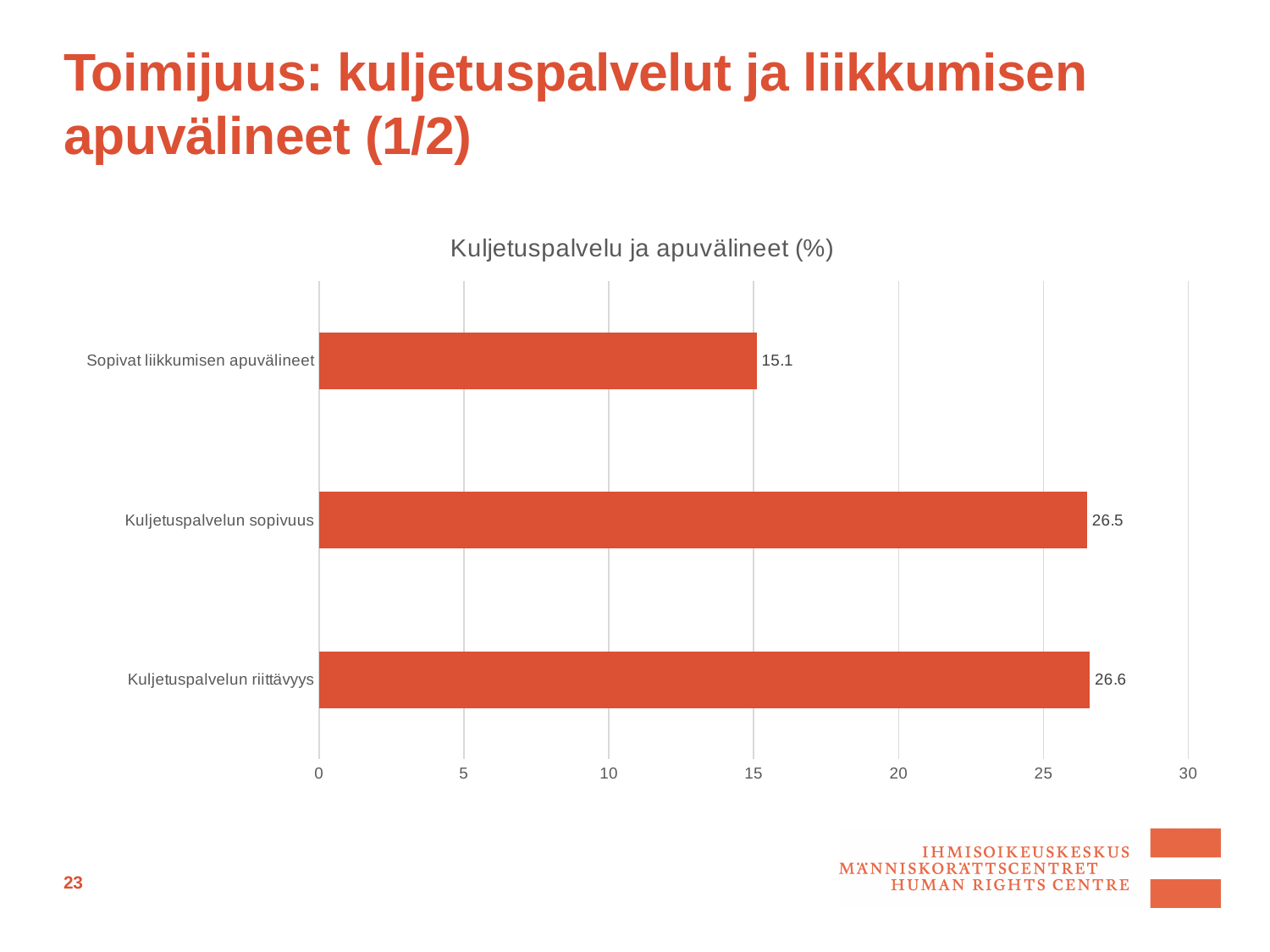
Which category has the lowest value? Sopivat liikkumisen apuvälineet Is the value for Kuljetuspalvelun riittävyys greater or less than 25? greater Is the value for Sopivat liikkumisen apuvälineet greater or less than 20? less What is the value for Sopivat liikkumisen apuvälineet? 15.1 What is the difference between the values for Kuljetuspalvelun sopivuus and Sopivat liikkumisen apuvälineet? 11.4 What is the difference between the values for Kuljetuspalvelun riittävyys and Sopivat liikkumisen apuvälineet? 11.5 What is the value for Kuljetuspalvelun sopivuus? 26.5 How many categories are shown in the chart? 3 What type of chart is shown on the slide? Bar chart Which category has the highest value? Kuljetuspalvelun riittävyys Which is larger, the value for Kuljetuspalvelun sopivuus or the value for Sopivat liikkumisen apuvälineet? Kuljetuspalvelun sopivuus What is the value for Kuljetuspalvelun riittävyys? 26.6